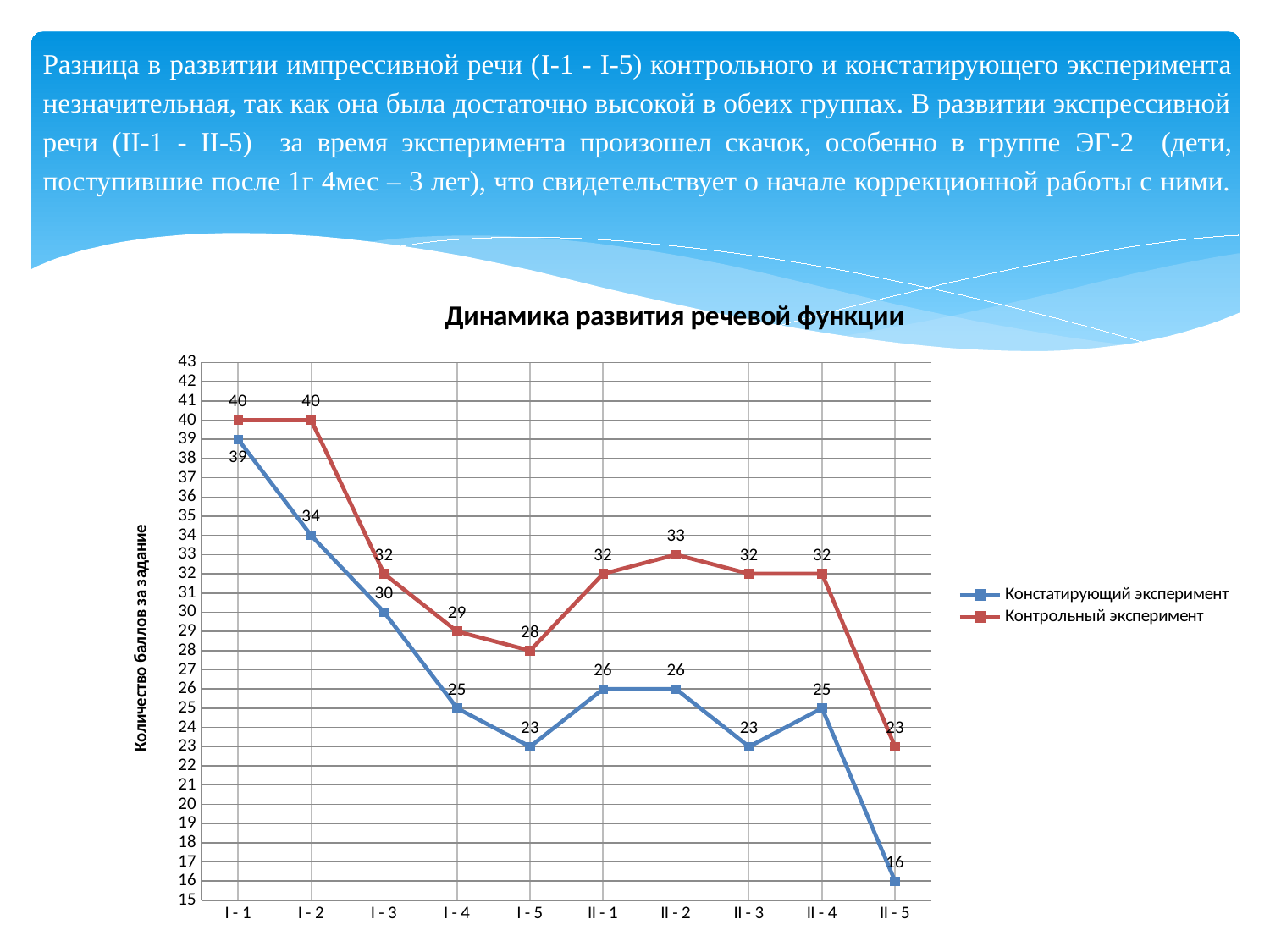
How many series does the legend list? 2 What type of chart is shown on the slide? line chart What is the value for Констатирующий эксперимент at I - 1? 39 At which category is the Констатирующий эксперимент value lowest? II - 5 What is the value for Констатирующий эксперимент at II - 5? 16 Do the Констатирующий эксперимент values rise or fall from I - 1 to I - 5? fall At which category is the Контрольный эксперимент value highest? I - 1 and I - 2 What is the title of the chart? Динамика развития речевой функции What is the difference between Контрольный эксперимент and Констатирующий эксперимент at II - 5? 7 Which series has the larger value at I - 4? Контрольный эксперимент How many categories are shown on the x axis? 10 What is the value for Контрольный эксперимент at II - 2? 33